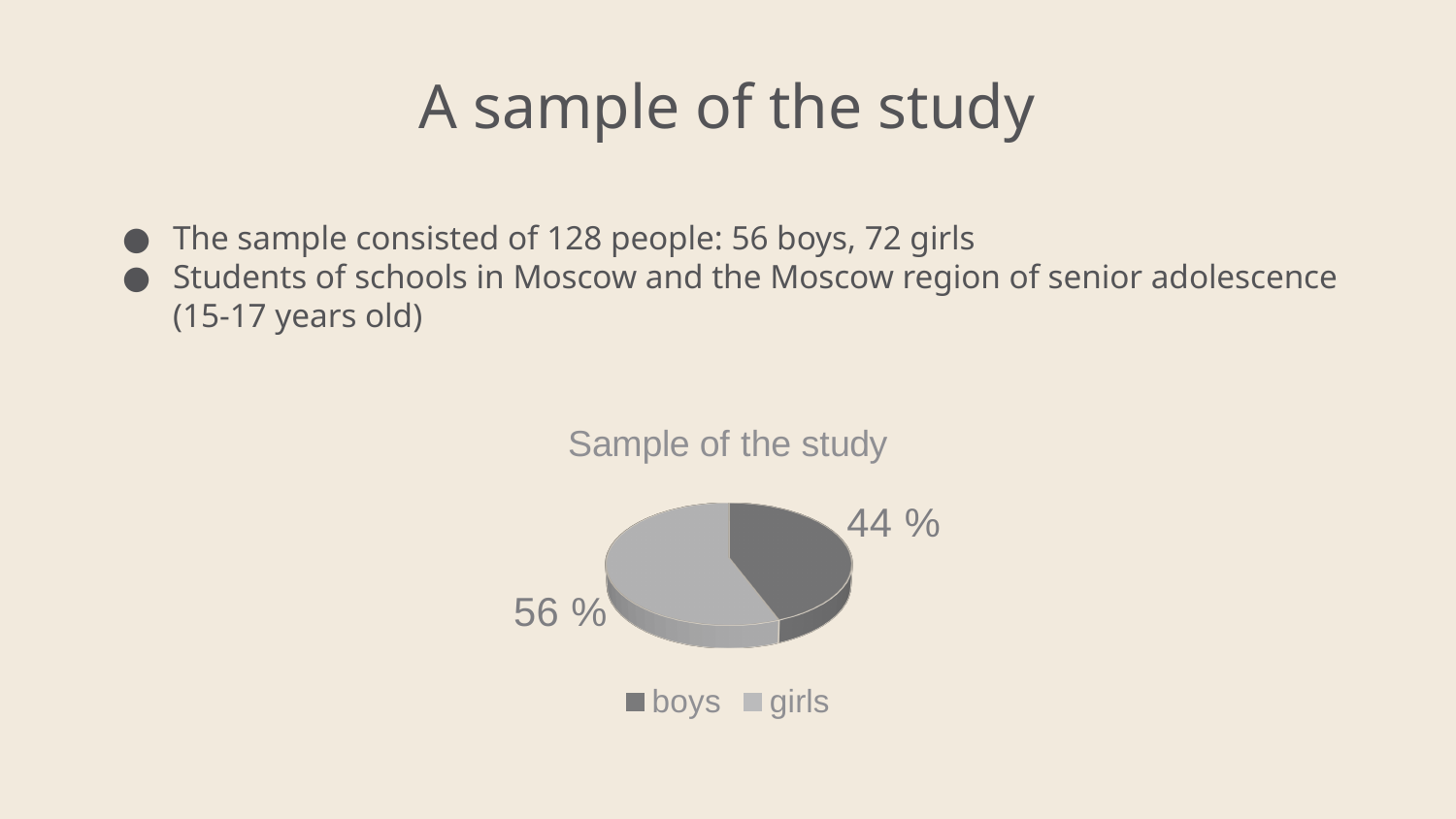
What percentage of the pie chart is labelled for girls? 56 % How many entries does the legend list? 2 Which slice is larger, boys or girls? girls What is the title of the chart? Sample of the study Which legend entry is shown in the darker grey colour? boys Which slice of the pie chart is the smallest? boys Which slice of the pie chart is the largest? girls What is the difference in percentage points between the girls slice and the boys slice? 12 What percentage of the pie chart is labelled for boys? 44 % What type of chart is shown on the slide? pie chart Is the share for boys greater or less than 50%? less How many slices does the pie chart have? 2